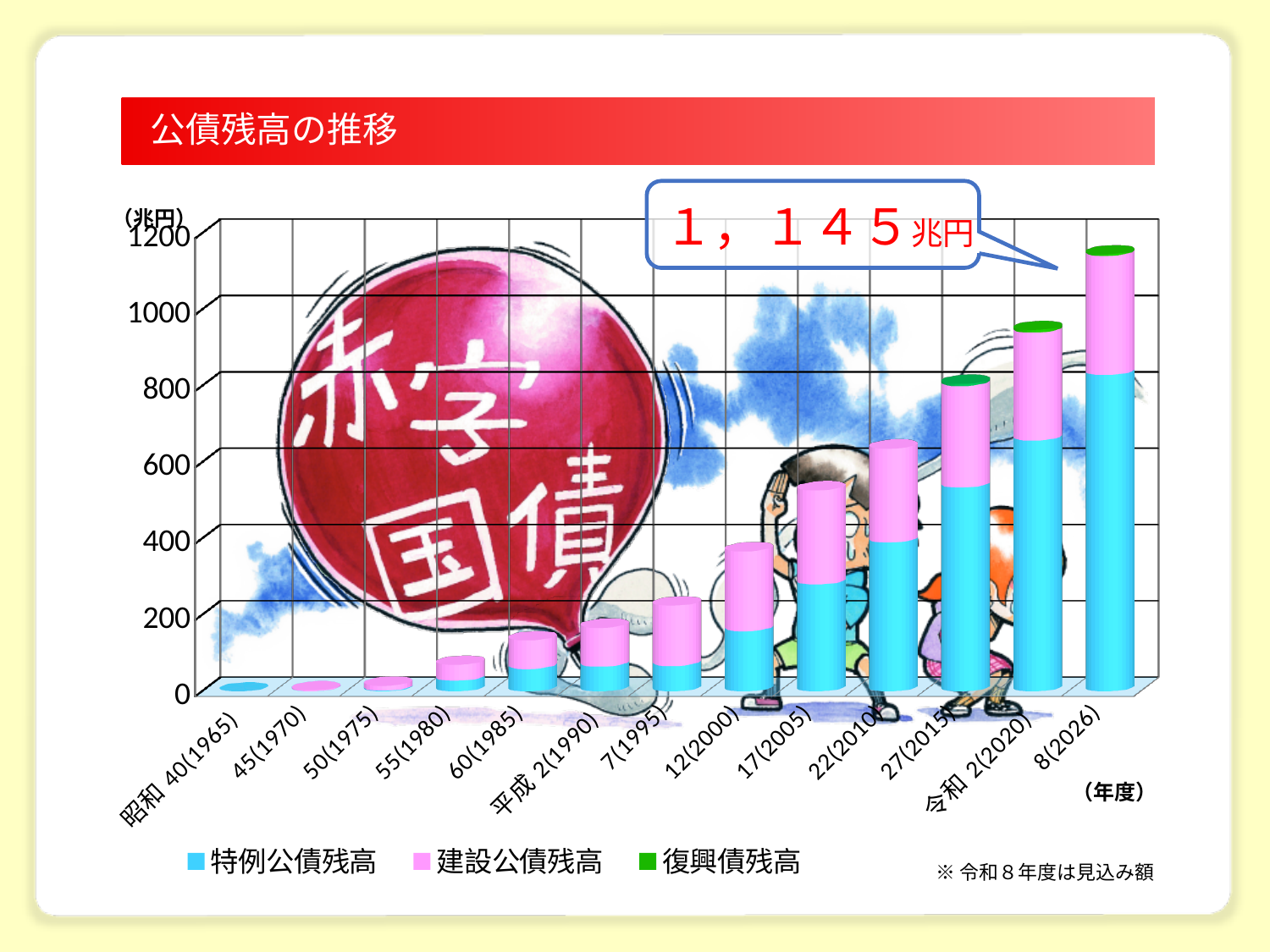
How many fiscal-year categories are shown on the x axis? 13 How many series does the legend list? 3 Which has the larger total bar, 27(2015) or 令和2(2020)? 令和2(2020) Is the total value for 令和2(2020) greater or less than 800? greater What kind of chart is shown on the slide? bar chart Which fiscal year has the highest total bar? 8(2026) Is the total value for 12(2000) greater or less than 400? less What colour represents 復興債残高 in the legend? green Do the total bar values rise or fall from 昭和40(1965) to 8(2026)? rise What is the title of the chart? 公債残高の推移 Which fiscal year has the lowest total bar? 昭和40(1965) What is the total outstanding bond balance shown for 8(2026)? 1,145兆円